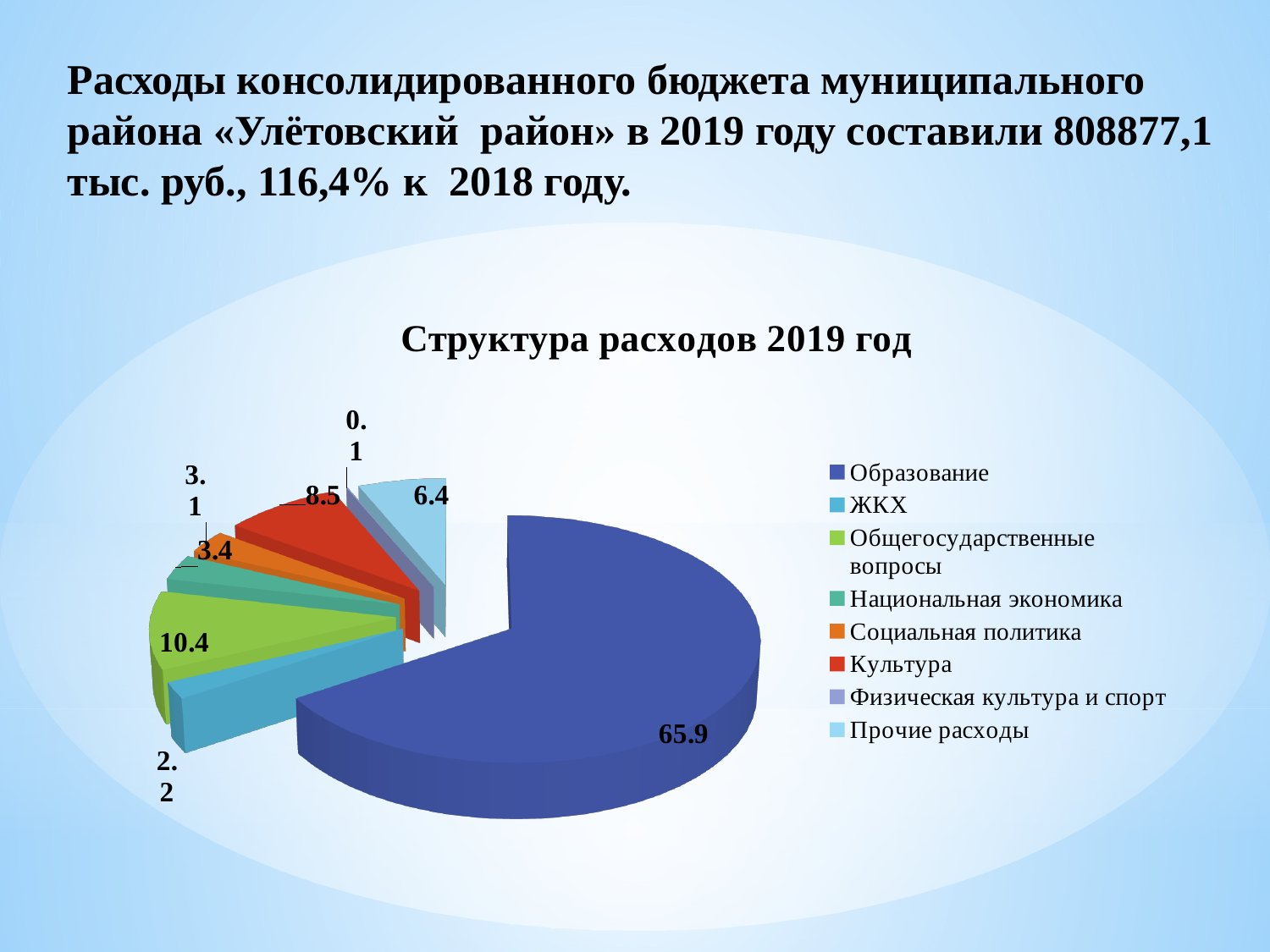
What is the value shown for Культура? 8.5 What is the value shown for Общегосударственные вопросы? 10.4 What type of chart is shown on the slide? pie chart What is the title of the chart? Структура расходов 2019 год How many categories does the legend of the pie chart list? 8 What is the difference between the values for Общегосударственные вопросы and Национальная экономика? 7.0 Which category has the smallest share of the pie? Физическая культура и спорт What is the value shown for Прочие расходы? 6.4 What is the value shown for ЖКХ? 2.2 Which category has the largest share of the pie? Образование What is the value shown for Образование? 65.9 Which is larger, the value for Культура or the value for Прочие расходы? Культура